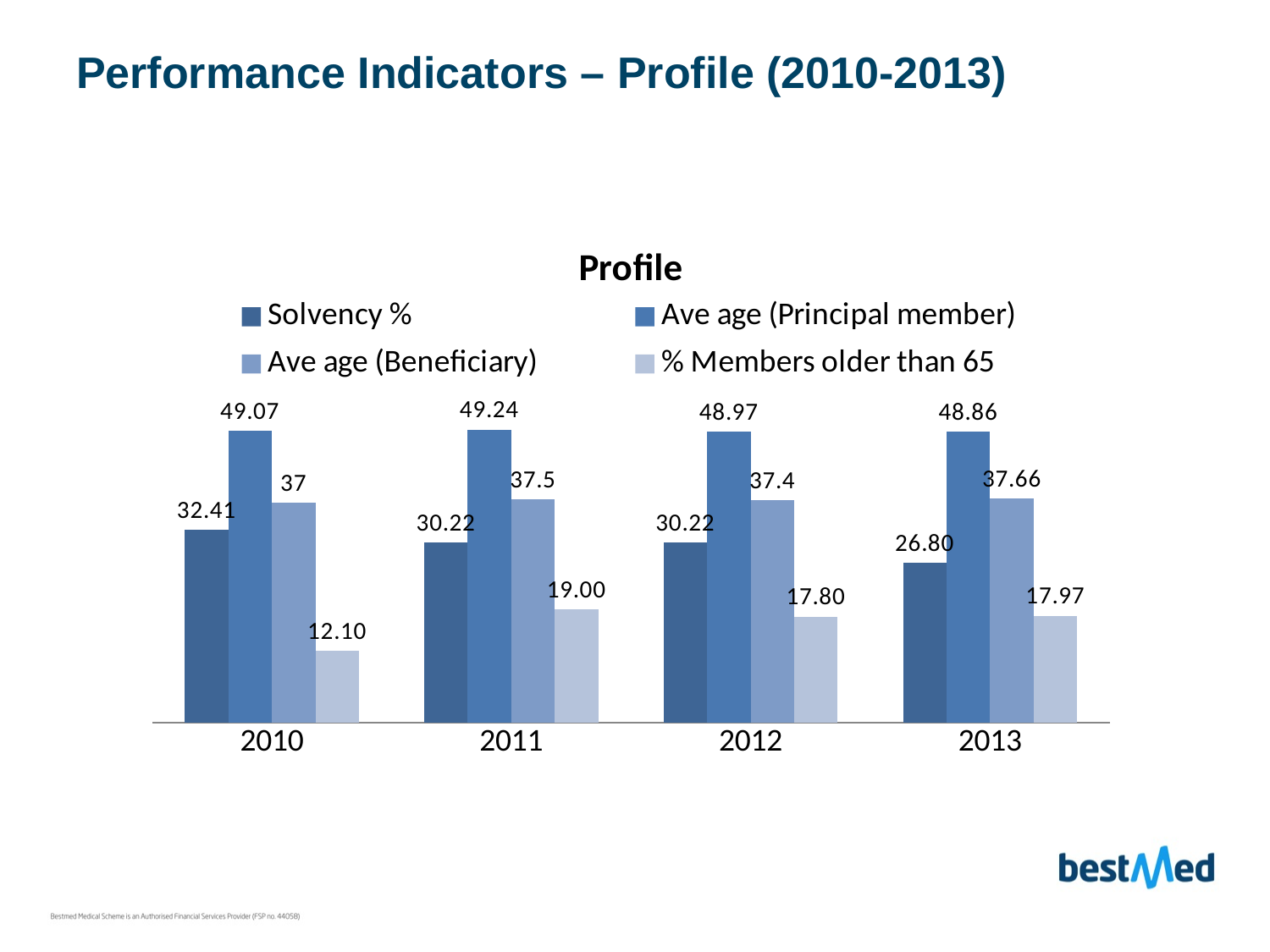
In which year is % Members older than 65 highest? 2011 Which is larger: % Members older than 65 in 2010 or in 2011? 2011 Does Solvency % rise or fall from 2010 to 2013? fall What kind of chart is shown? bar chart What is the Ave age (Beneficiary) value for 2013? 37.66 What is the Solvency % value for 2010? 32.41 What is the Ave age (Principal member) value for 2011? 49.24 What is the difference between the Solvency % values for 2010 and 2013? 5.61 What is the % Members older than 65 value for 2012? 17.80 How many years are shown on the x axis? 4 How many series does the legend list? 4 In which year is Solvency % lowest? 2013